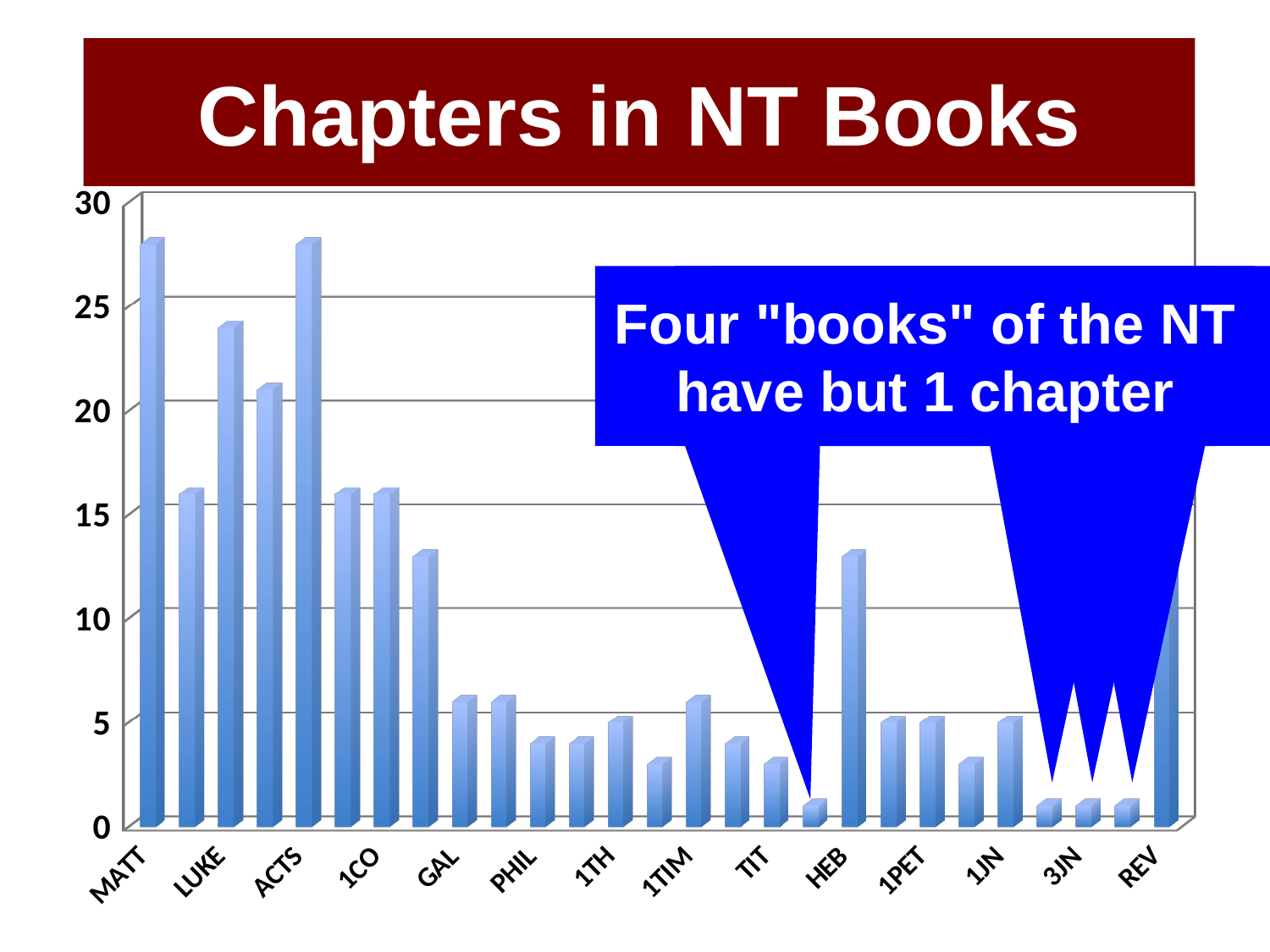
What is the title of the chart? Chapters in NT Books According to the callout on the chart, how many NT books have only 1 chapter? Four Which has the larger value, LUKE or HEB? LUKE How many bars are plotted in the chart? 27 Is the value for TIT greater or less than 5? less What kind of chart is shown on the slide? bar chart Is the value for LUKE greater or less than 20? greater Which has the larger value, GAL or REV? REV Is the value for HEB greater or less than 10? greater